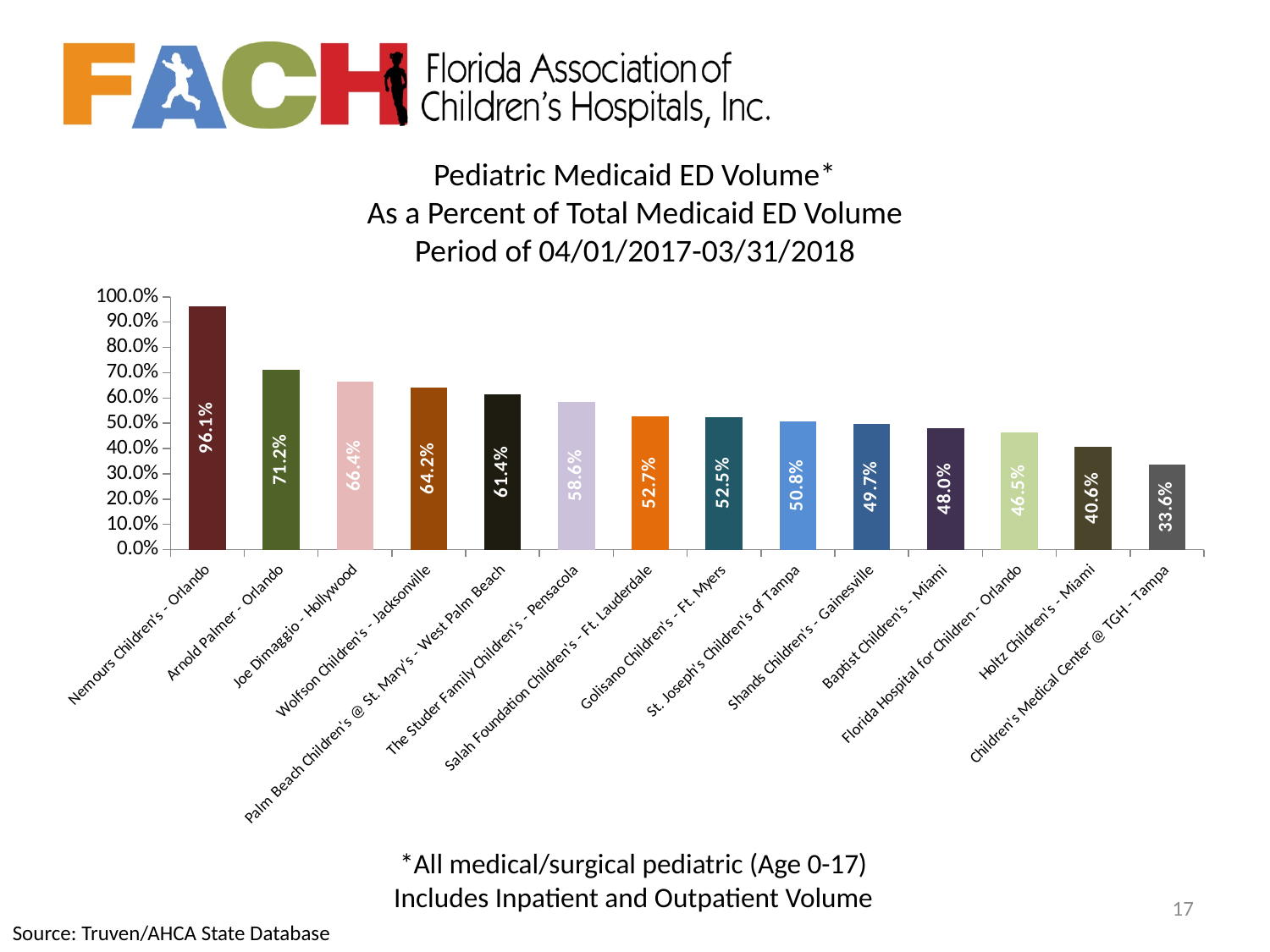
Is the value for Joe Dimaggio - Hollywood greater or less than 60.0%? greater What is the value for Nemours Children's - Orlando? 96.1% What is the difference between the values for Nemours Children's - Orlando and Arnold Palmer - Orlando? 24.9% What is the value for Wolfson Children's - Jacksonville? 64.2% What period does the chart cover according to its title? 04/01/2017-03/31/2018 What is the value for Shands Children's - Gainesville? 49.7% Which is larger, the value for Holtz Children's - Miami or the value for Baptist Children's - Miami? Baptist Children's - Miami Do the values rise or fall from left to right across the chart? fall What kind of chart is shown on the slide? bar chart How many hospitals are shown in the chart? 14 Which hospital has the highest Pediatric Medicaid ED Volume percentage? Nemours Children's - Orlando Which hospital has the lowest Pediatric Medicaid ED Volume percentage? Children's Medical Center @ TGH - Tampa